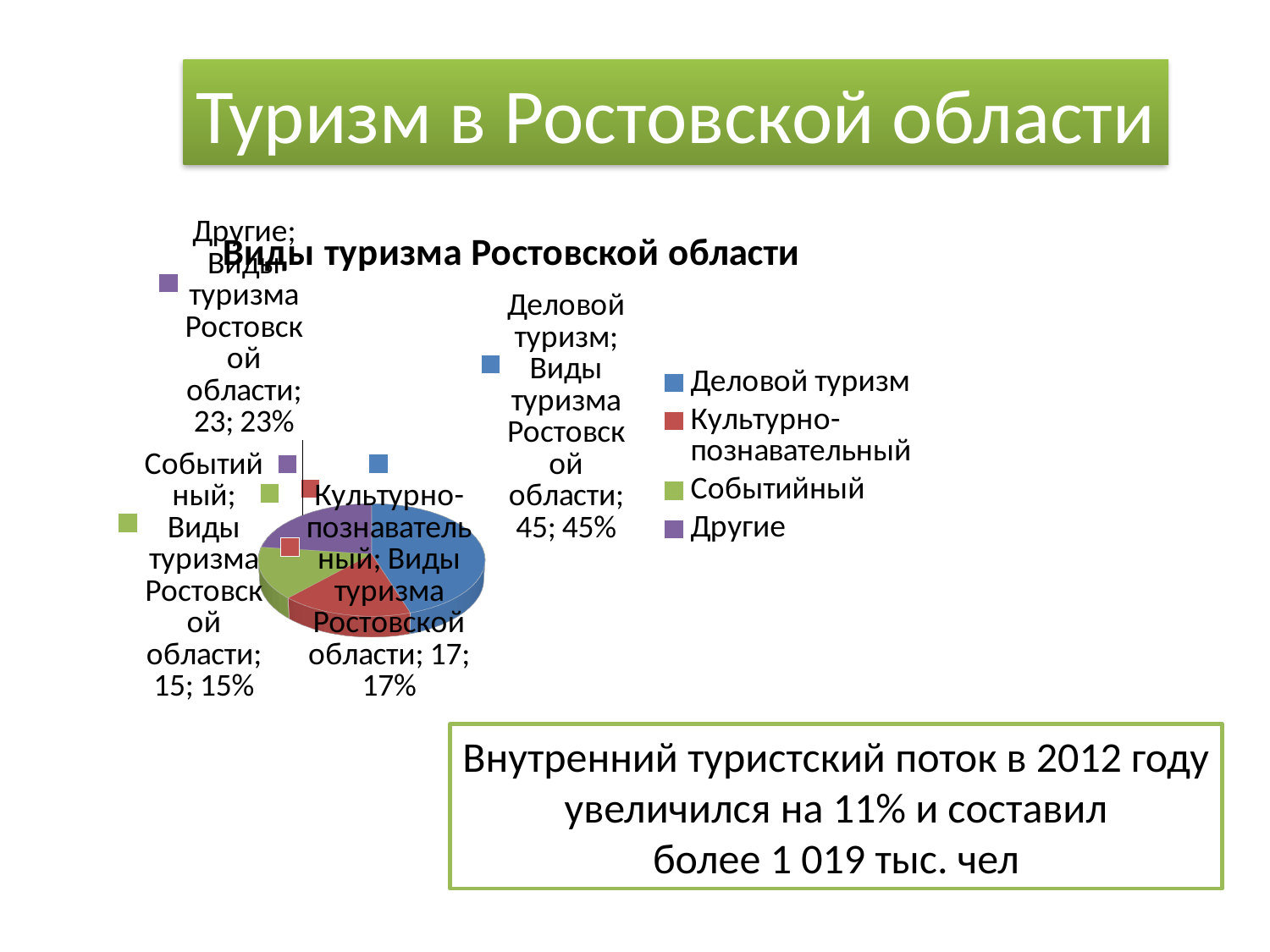
Which category has the smallest slice of the pie? Событийный What is the value shown for Культурно-познавательный? 17 What share of the pie does Событийный take? 15% Which category has the largest slice of the pie? Деловой туризм What is the value shown for Другие? 23 What kind of chart is shown on the slide? pie chart How many slices does the pie chart have? 4 What share of the pie does Деловой туризм take? 45% What is the title of the chart? Виды туризма Ростовской области What is the difference between the values for Деловой туризм and Другие? 22 Which legend entry is shown in green? Событийный Which is larger, the slice for Другие or the slice for Культурно-познавательный? Другие